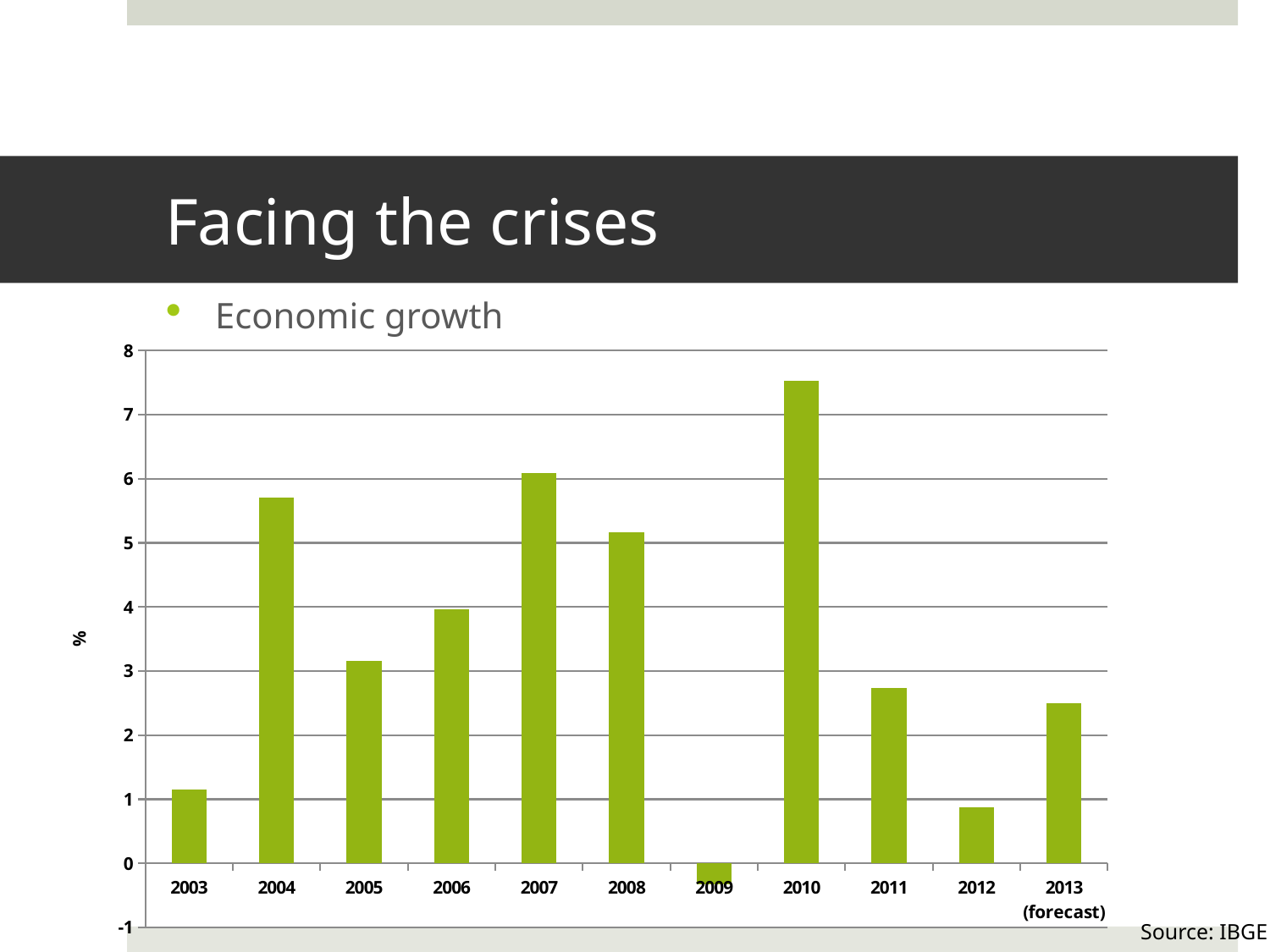
Which year has the lowest economic growth in the chart? 2009 What is the label on the y axis of the chart? % How many years are plotted on the x axis of the chart? 11 Is the value for 2011 greater or less than 3? less Is the value for 2010 greater or less than 7? greater Which year has the larger value, 2005 or 2006? 2006 Is the value for 2004 greater or less than 5? greater Which year has the highest economic growth in the chart? 2010 Do the values rise or fall from 2010 to 2012? fall What kind of chart is shown on the slide? bar chart Which year has the larger value, 2004 or 2008? 2004